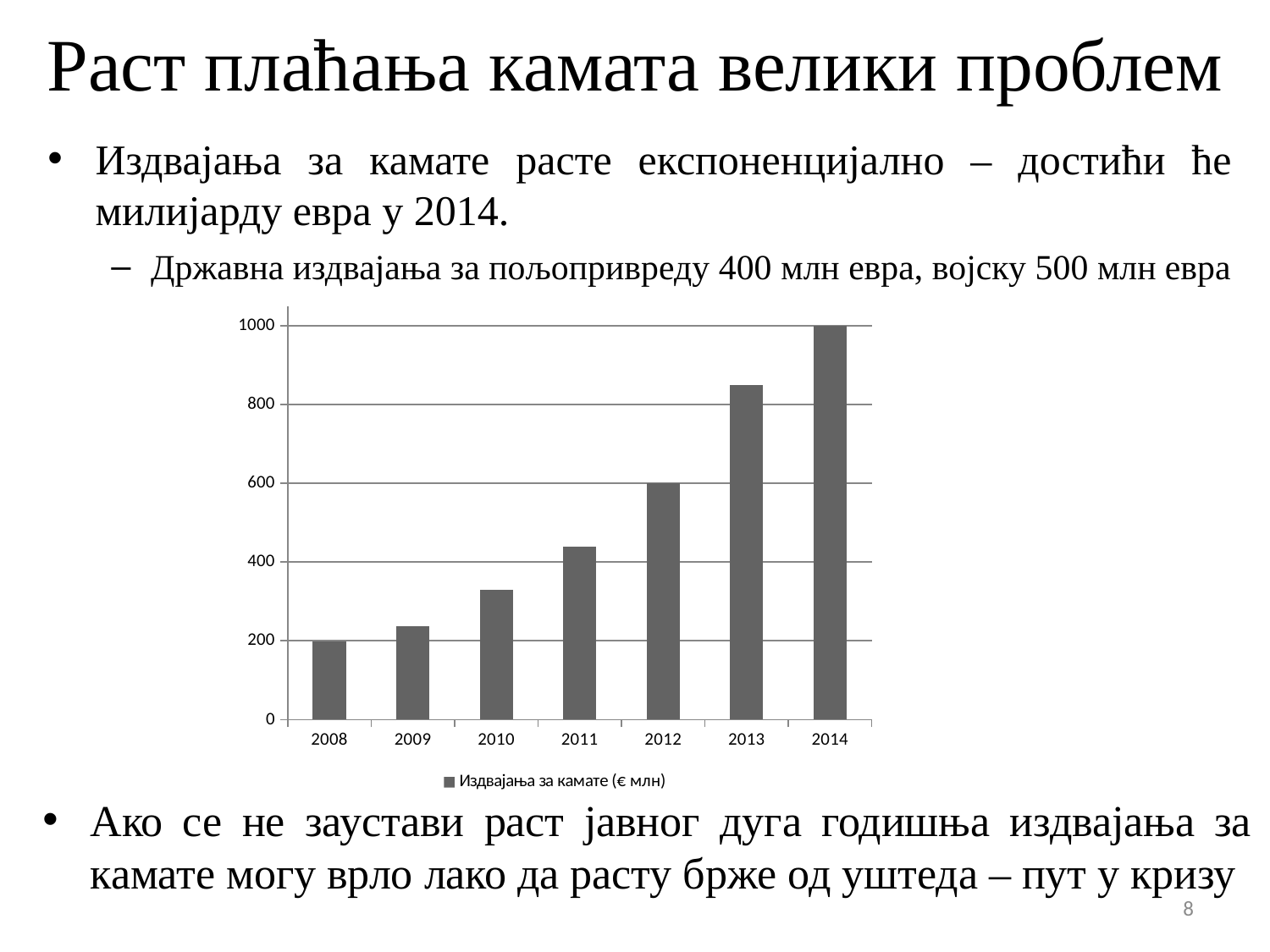
What is the name of the series shown in the chart legend? Издвајања за камате (€ млн) Which year has the lowest value in the chart? 2008 Do the values in the chart rise or fall from 2008 to 2014? rise Is the value for 2009 greater or less than 400? less Which year has the larger value, 2012 or 2010? 2012 What kind of chart is shown on the slide? bar chart How many years are shown on the x axis of the chart? 7 Which year has the highest value in the chart? 2014 Is the value for 2013 greater or less than 800? greater Is the value for 2011 greater or less than 400? greater How many series does the chart legend list? 1